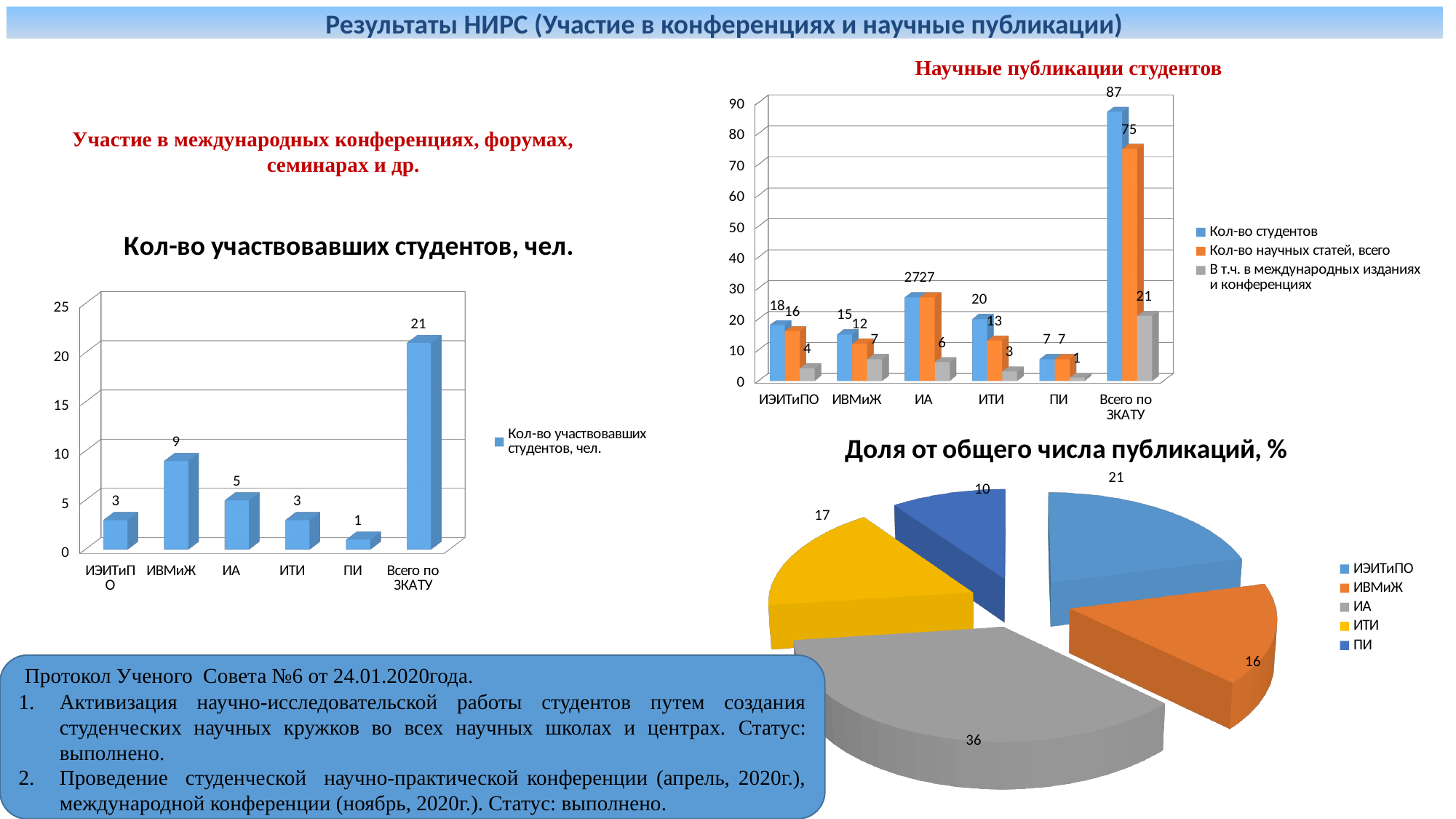
In the chart 'Научные публикации студентов', is the value of 'Кол-во студентов' for 'Всего по ЗКАТУ' greater or less than 80? greater How many categories are shown on the x axis of the chart 'Кол-во участвовавших студентов, чел.'? 6 In the chart 'Научные публикации студентов', what is the value of 'В т.ч. в международных изданиях и конференциях' for ИВМиЖ? 7 What type of chart is 'Кол-во участвовавших студентов, чел.'? bar chart In the chart 'Научные публикации студентов', which category other than 'Всего по ЗКАТУ' has the highest value of 'Кол-во студентов'? ИА In the pie chart 'Доля от общего числа публикаций, %', which category has the smallest slice? ПИ In the chart 'Кол-во участвовавших студентов, чел.', what is the value for ИВМиЖ? 9 How many series does the legend of the chart 'Научные публикации студентов' list? 3 In the chart 'Кол-во участвовавших студентов, чел.', which category other than 'Всего по ЗКАТУ' has the lowest value? ПИ In the pie chart 'Доля от общего числа публикаций, %', what is the share for ИА? 36 In the chart 'Научные публикации студентов', what is the value of 'Кол-во научных статей, всего' for ИТИ? 13 In the chart 'Кол-во участвовавших студентов, чел.', what is the difference between the values for ИВМиЖ and ИА? 4